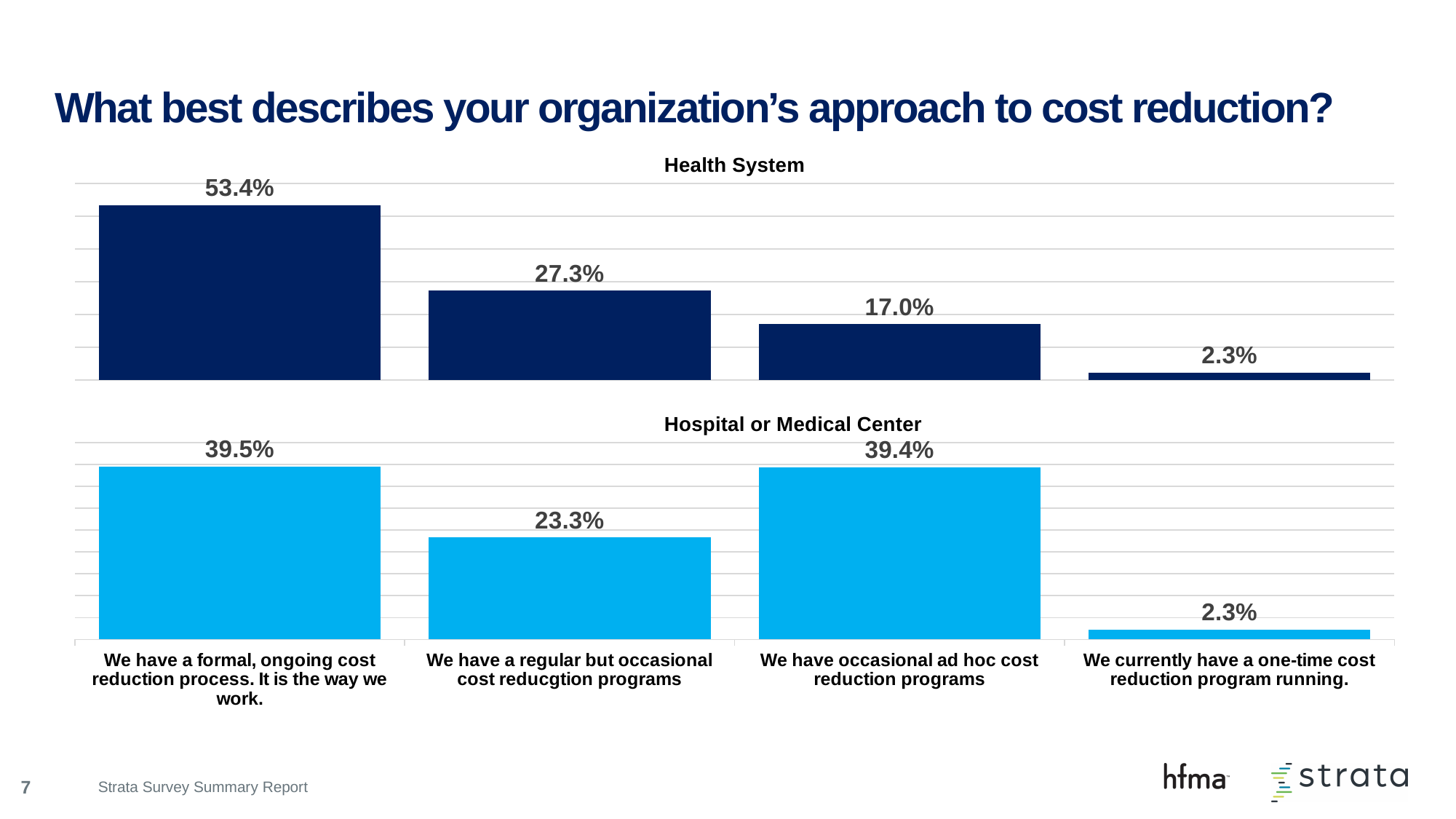
In the Hospital or Medical Center chart, which category has the lowest value? We currently have a one-time cost reduction program running. In the Health System chart, which category has the highest value? We have a formal, ongoing cost reduction process. It is the way we work. What is the difference between the Health System and Hospital or Medical Center values for 'We have occasional ad hoc cost reduction programs'? 22.4% In the Health System chart, which category has the lowest value? We currently have a one-time cost reduction program running. In the Hospital or Medical Center chart, what is the value for 'We have occasional ad hoc cost reduction programs'? 39.4% How many categories are shown in the Hospital or Medical Center chart? 4 In the Health System chart, what is the difference between the value for the formal, ongoing cost reduction process and the value for regular but occasional programs? 26.1% What type of chart is the Health System chart? Bar chart In the Hospital or Medical Center chart, what is the value for 'We have a regular but occasional cost reducgtion programs'? 23.3% In the Health System chart, what percentage of respondents said they have a formal, ongoing cost reduction process? 53.4% In the Health System chart, which is larger: the value for regular but occasional programs or the value for occasional ad hoc programs? We have a regular but occasional cost reducgtion programs Do the values in the Health System chart rise or fall from left to right? Fall